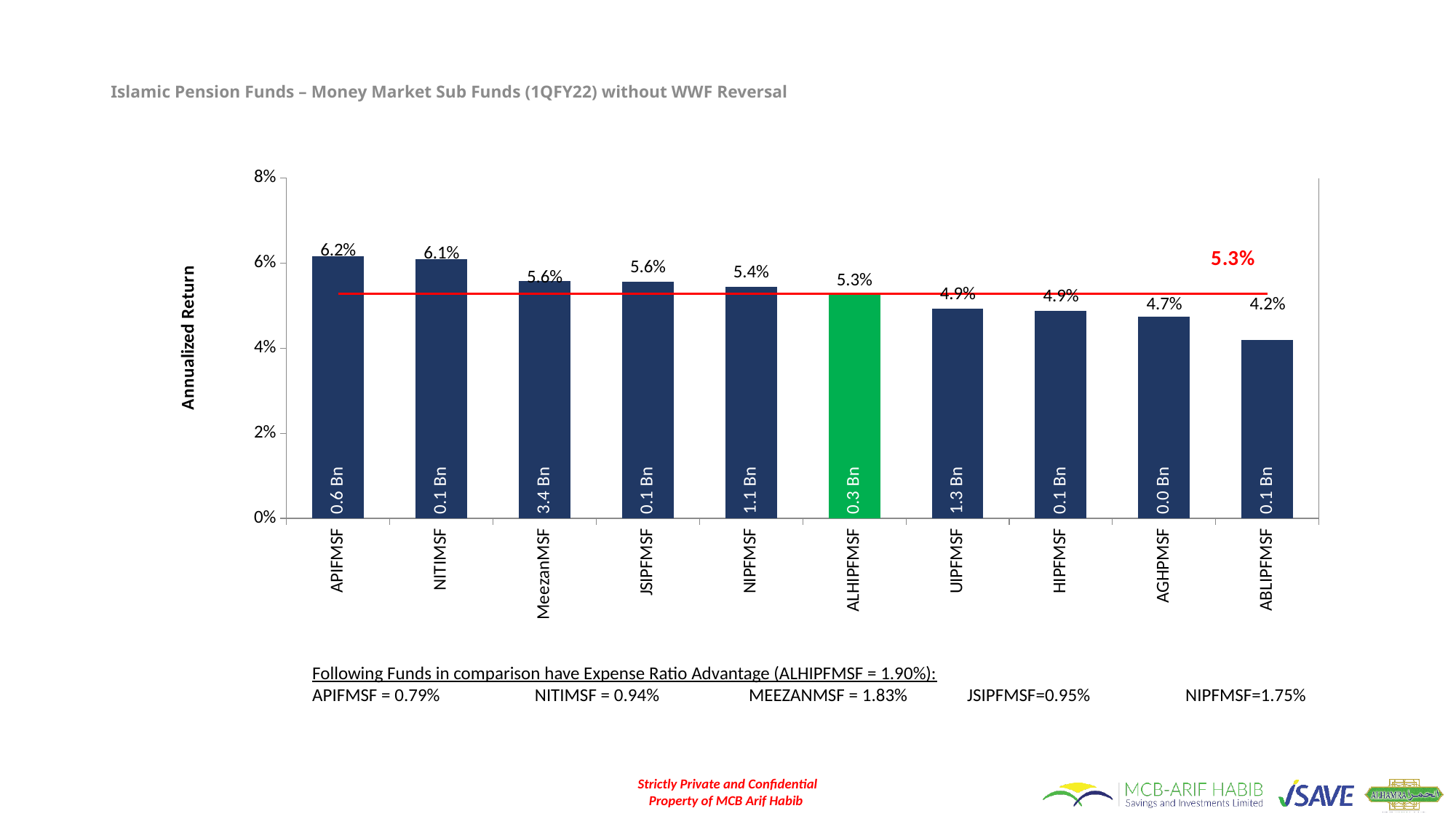
What is the annualized return for APIFMSF? 6.2% Which fund has the highest annualized return? APIFMSF Which fund has the lowest annualized return? ABLIPFMSF What is the annualized return for ABLIPFMSF? 4.2% Which has a higher annualized return, NITIMSF or NIPFMSF? NITIMSF What fund size is printed inside the MeezanMSF bar? 3.4 Bn What is the difference in annualized return between APIFMSF and ABLIPFMSF? 2.0% How many funds are shown on the chart? 10 What type of chart is shown on the slide? Bar chart What is the annualized return for ALHIPFMSF? 5.3% Which fund's bar is coloured green? ALHIPFMSF Do the annualized returns rise or fall moving from left to right across the chart? Fall